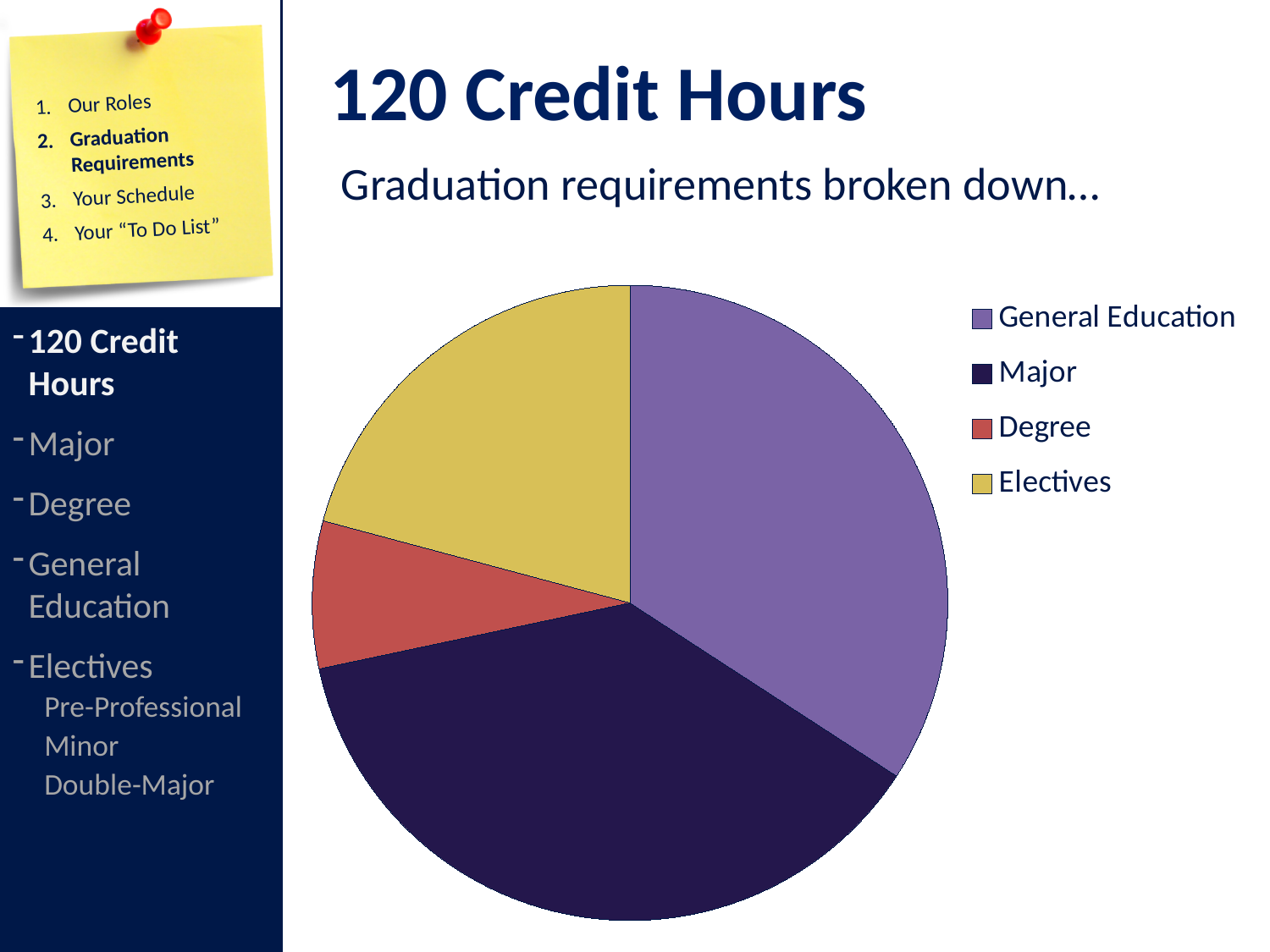
Which slice is larger in the pie chart, Electives or Degree? Electives Which slice is larger in the pie chart, General Education or Electives? General Education What kind of chart is shown on the slide? pie chart How many slices does the pie chart have? 4 Which category has the smallest slice in the pie chart? Degree Which slice is larger in the pie chart, Major or Degree? Major What is the title of the slide containing the pie chart? 120 Credit Hours How many entries does the legend of the pie chart list? 4 Which category is shown in yellow in the pie chart? Electives